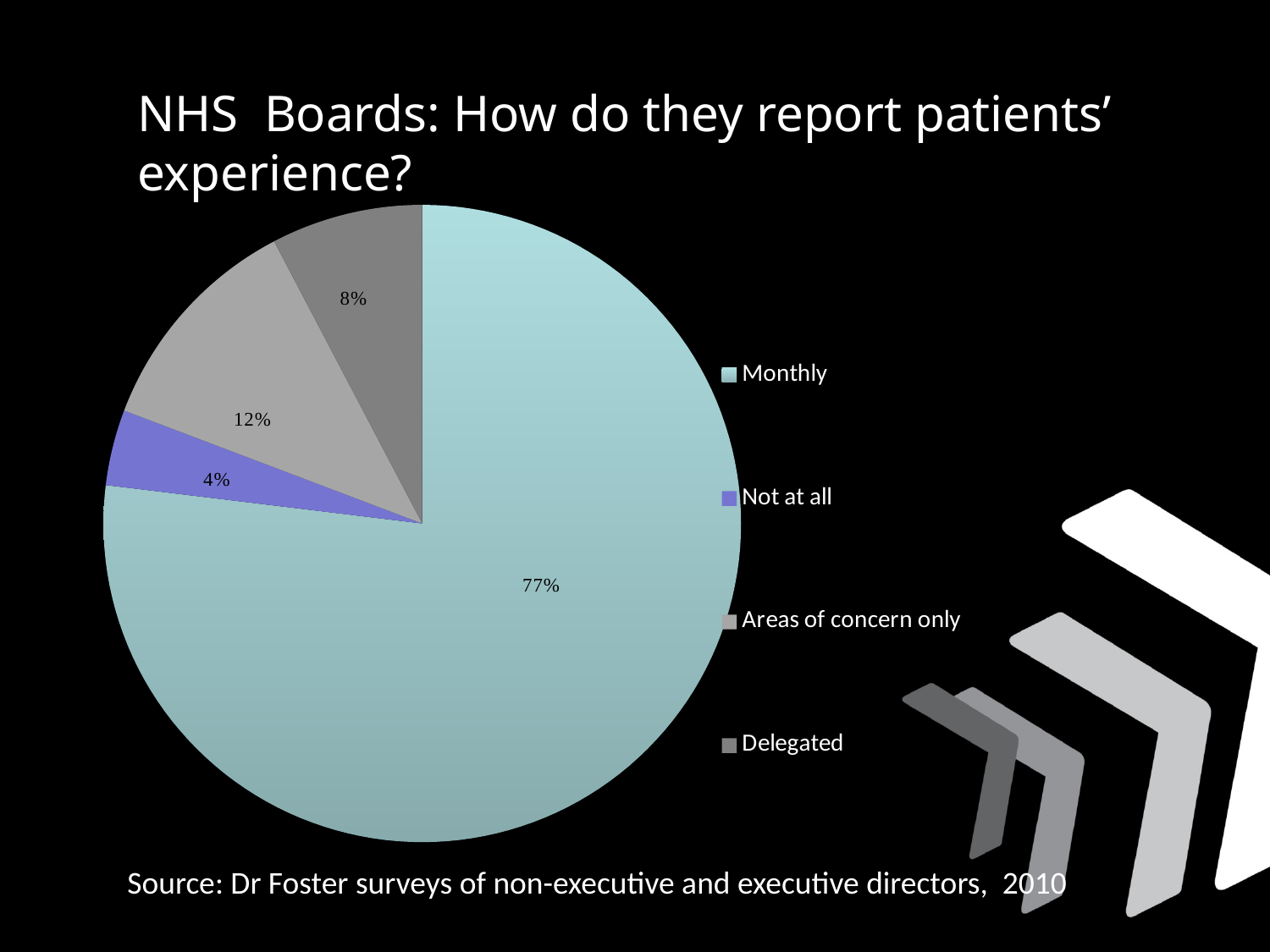
What share of the pie is labelled Not at all? 4% Which category has the smallest slice of the pie? Not at all What source is cited for the chart data? Dr Foster surveys of non-executive and executive directors, 2010 Which category has the largest slice of the pie? Monthly What share of the pie is labelled Delegated? 8% How many categories does the legend list? 4 What is the title of the slide containing the chart? NHS Boards: How do they report patients' experience? Which slice is larger, Delegated or Areas of concern only? Areas of concern only What share of the pie is labelled Monthly? 77% What kind of chart is shown on the slide? pie chart What is the difference in percentage points between the Monthly slice and the Areas of concern only slice? 65